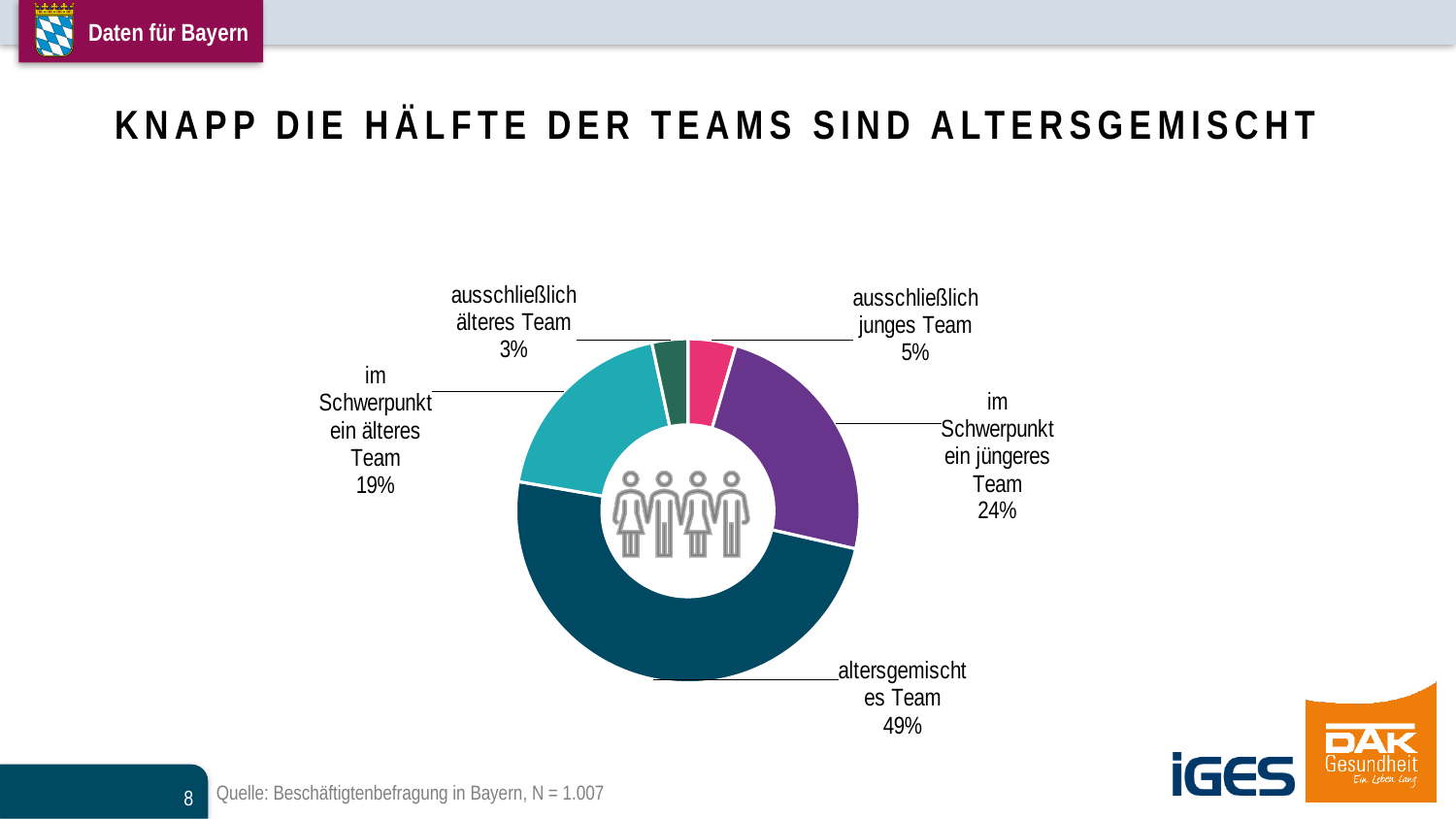
What is the title of the slide? KNAPP DIE HÄLFTE DER TEAMS SIND ALTERSGEMISCHT What percentage is shown for 'im Schwerpunkt ein jüngeres Team'? 24% Which is larger: the share for 'ausschließlich junges Team' or for 'ausschließlich älteres Team'? ausschließlich junges Team What is the difference in percentage points between 'im Schwerpunkt ein jüngeres Team' and 'im Schwerpunkt ein älteres Team'? 5 percentage points What kind of chart is shown on the slide? Pie chart (donut) Which category has the largest share of the pie? altersgemischtes Team What is the combined share of 'ausschließlich älteres Team' and 'im Schwerpunkt ein älteres Team'? 22% What percentage is shown for 'im Schwerpunkt ein älteres Team'? 19% What percentage is shown for 'ausschließlich junges Team'? 5% What share of teams are altersgemischtes Team? 49% Which category has the smallest share of the pie? ausschließlich älteres Team How many categories are shown in the chart? 5